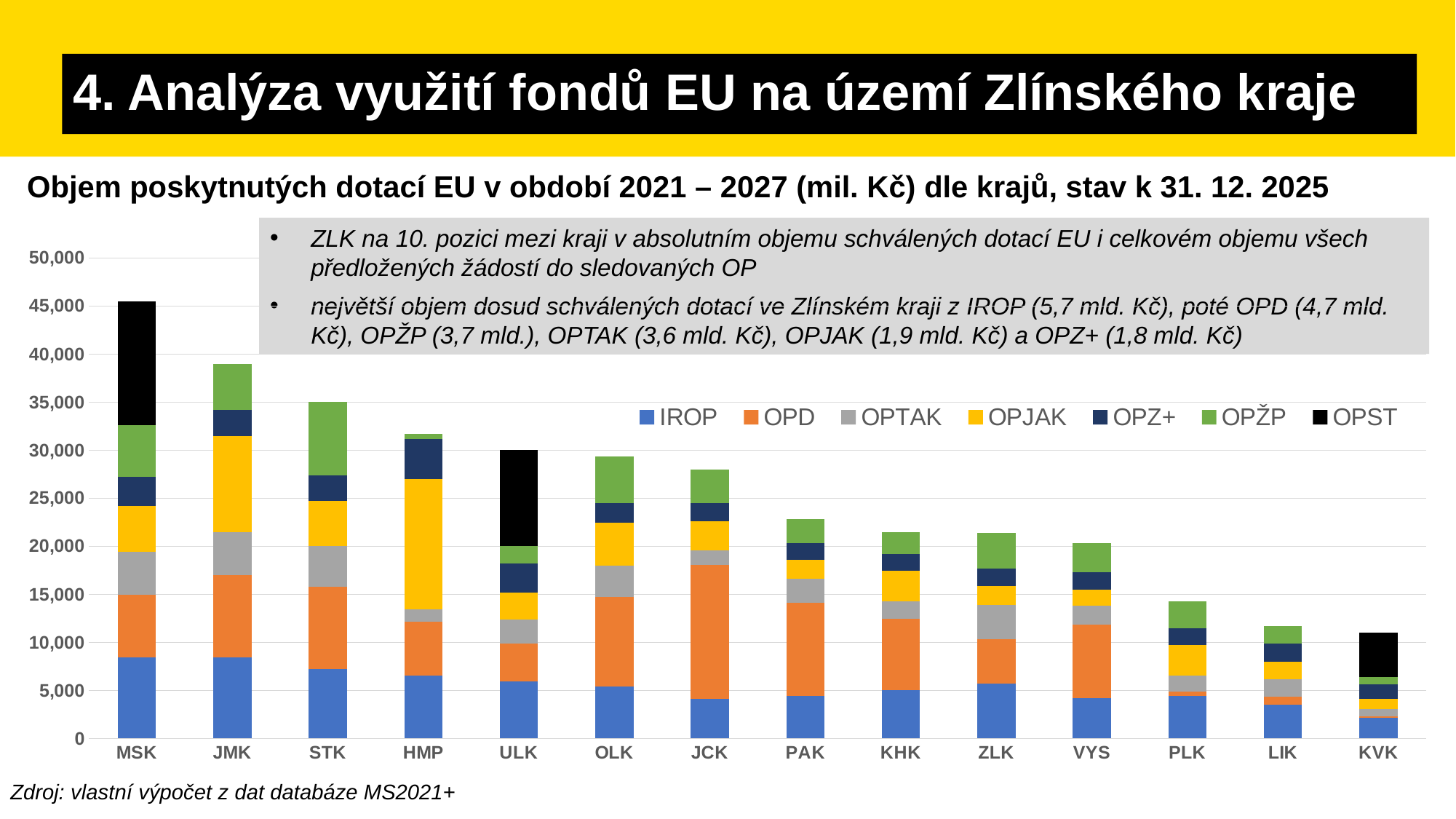
Which region has the larger total bar, MSK or JMK? MSK How many regions (categories) are shown on the x axis of the chart? 14 How many series does the chart legend list? 7 Is the total value for JMK greater or less than 35,000? greater Which region has the larger total bar, PLK or LIK? PLK Is the total value for PLK greater or less than 15,000? less Which region has the highest total bar in the chart? MSK Is the total value for JCK greater or less than 30,000? less Which series in the legend is shown in black? OPST What kind of chart is shown on the slide? Stacked bar chart Do the total bar values generally rise or fall from left to right along the x axis? fall